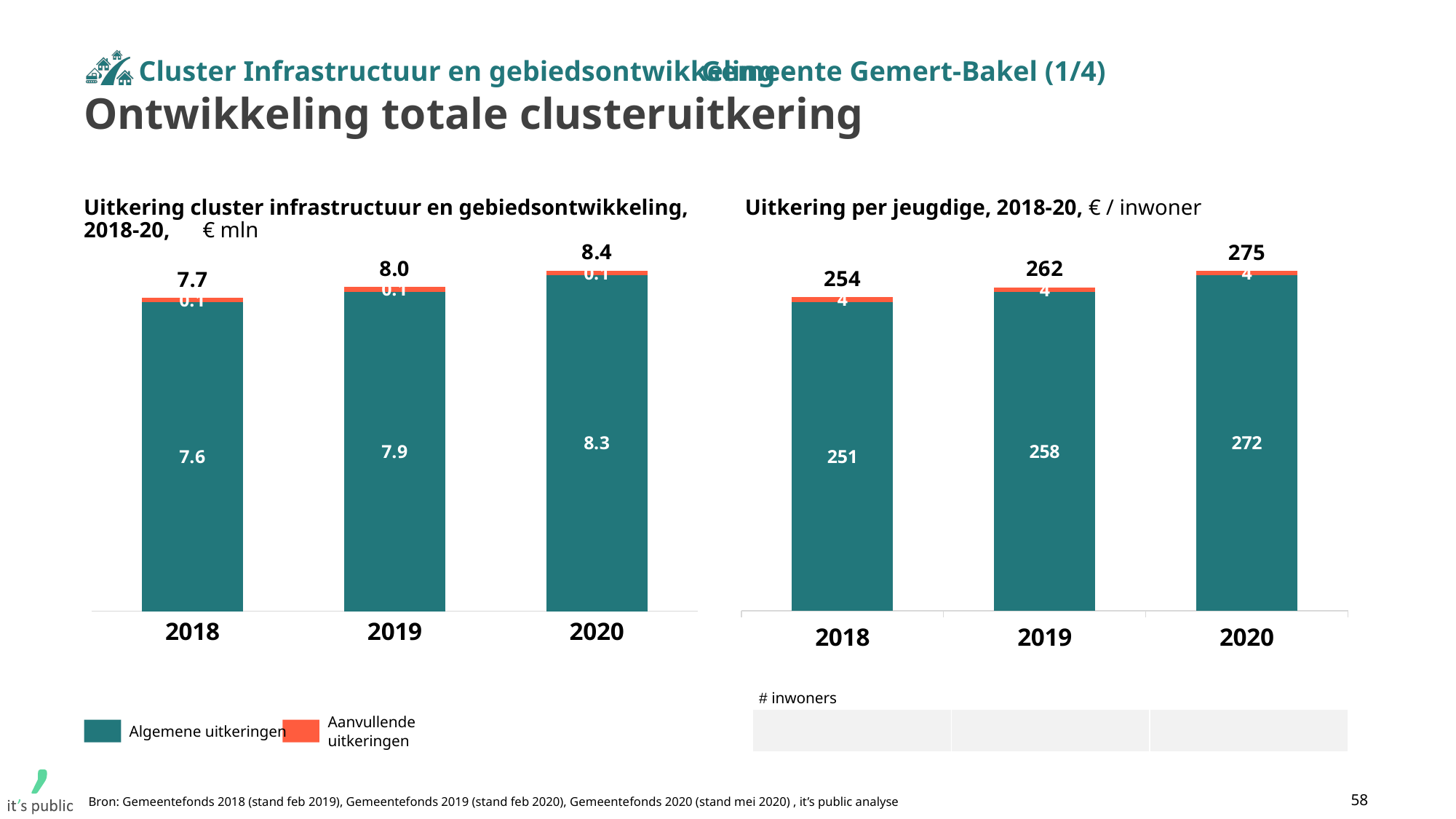
In the right chart (Uitkering per jeugdige), which year has the highest total? 2020 How many series does the legend list for the left chart (Uitkering cluster infrastructuur en gebiedsontwikkeling)? 2 In the right chart (Uitkering per jeugdige), what is the value of Algemene uitkeringen for 2020? 272 In the left chart (Uitkering cluster infrastructuur en gebiedsontwikkeling), which year has the lowest total? 2018 In the right chart (Uitkering per jeugdige), is the Algemene uitkeringen value for 2018 larger or smaller than that for 2020? smaller How many years are shown on the x axis of the left chart (Uitkering cluster infrastructuur en gebiedsontwikkeling)? 3 In the left chart (Uitkering cluster infrastructuur en gebiedsontwikkeling), what is the total of the stacked bar for 2020? 8.4 In the left chart (Uitkering cluster infrastructuur en gebiedsontwikkeling), what is the value of Algemene uitkeringen for 2019? 7.9 In the left chart (Uitkering cluster infrastructuur en gebiedsontwikkeling), what is the difference between the Algemene uitkeringen values for 2020 and 2018? 0.7 In the right chart (Uitkering per jeugdige), what is the total shown above the bar for 2019? 262 In the right chart (Uitkering per jeugdige), what is the difference between the Algemene uitkeringen values for 2019 and 2018? 7 In the left chart (Uitkering cluster infrastructuur en gebiedsontwikkeling), do the totals rise or fall from 2018 to 2020? rise